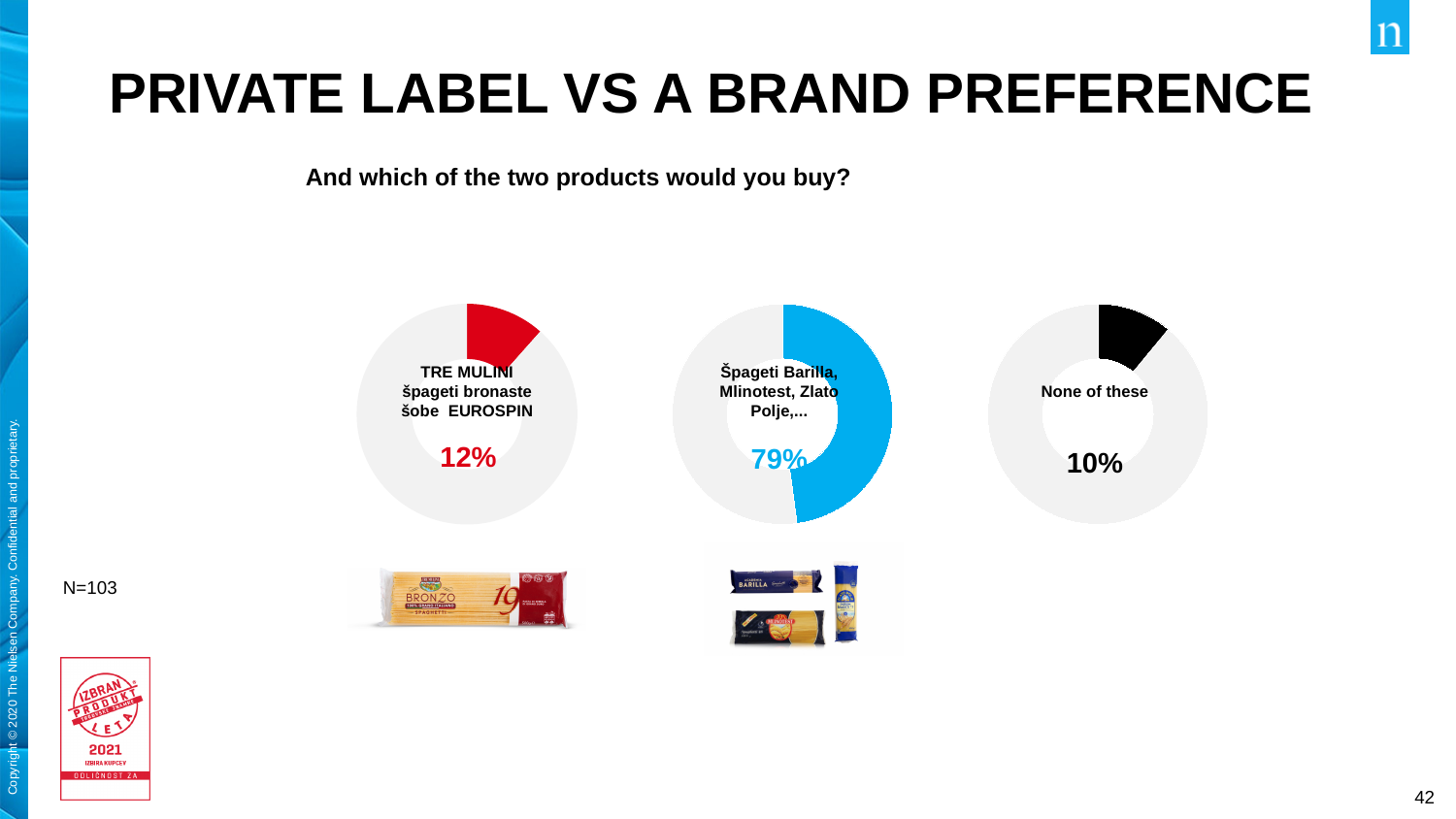
What type of chart is used to show the results on this slide? Donut (pie) chart Which option has the highest share of respondents? Špageti Barilla, Mlinotest, Zlato Polje,... Which is larger: the share for TRE MULINI špageti bronaste šobe EUROSPIN or the share for None of these? TRE MULINI špageti bronaste šobe EUROSPIN What is the sample size (N) stated on the slide? N=103 What percentage of respondents chose None of these? 10% What percentage of respondents would buy Špageti Barilla, Mlinotest, Zlato Polje,...? 79% What is the difference in percentage points between the Špageti Barilla, Mlinotest, Zlato Polje,... share and the TRE MULINI špageti bronaste šobe EUROSPIN share? 67 percentage points Which option has the lowest share of respondents? None of these How many donut charts are shown on the slide? 3 What colour is the highlighted segment in the Špageti Barilla, Mlinotest, Zlato Polje,... chart? Blue What percentage of respondents would buy TRE MULINI špageti bronaste šobe EUROSPIN? 12% What is the combined share of respondents who chose one of the two products (TRE MULINI EUROSPIN or Špageti Barilla, Mlinotest, Zlato Polje,...)? 91%